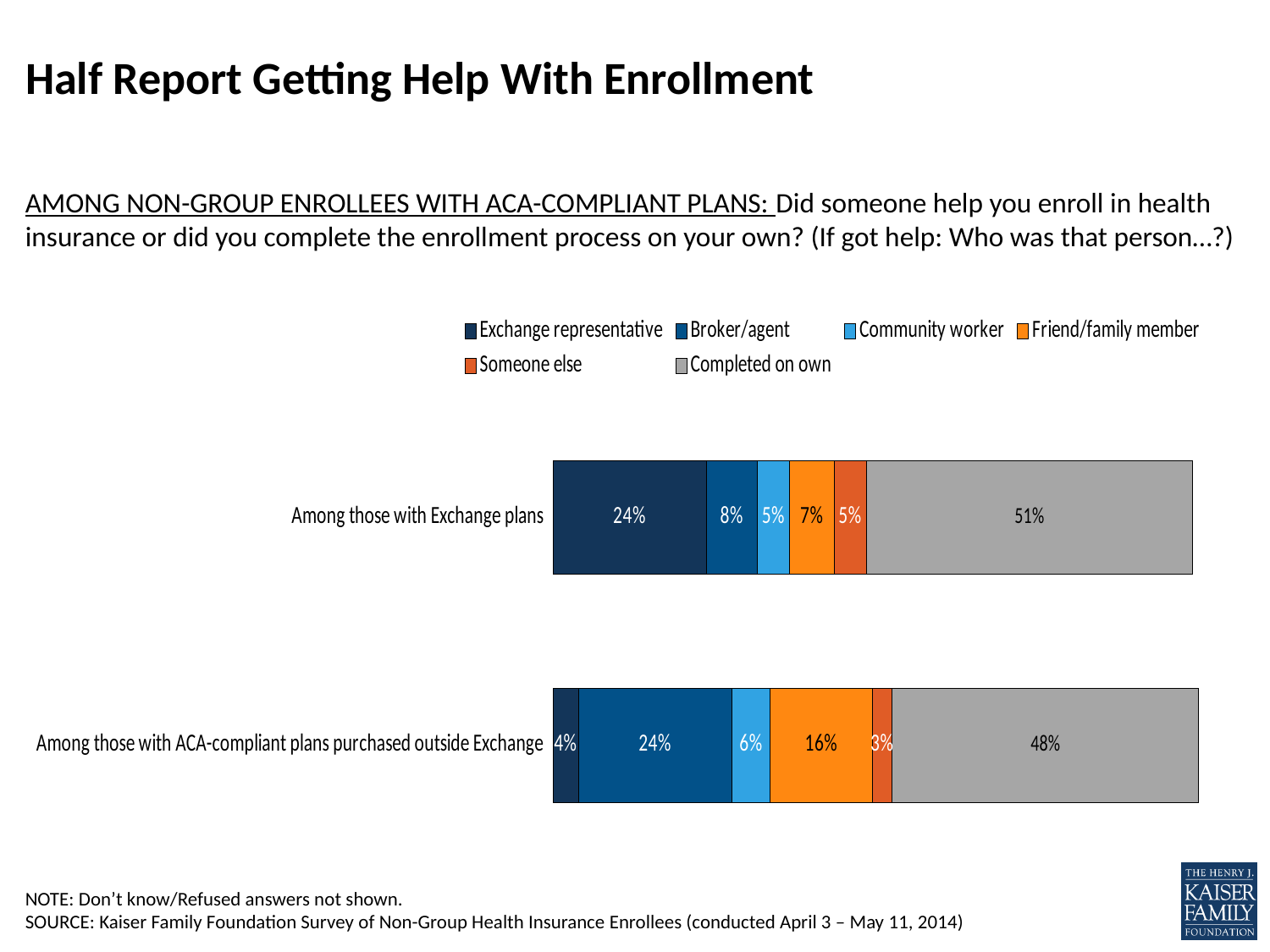
What percentage of those with Exchange plans got help from an Exchange representative? 24% What is the difference between the broker/agent share for those with plans purchased outside the Exchange and those with Exchange plans? 16 percentage points What percentage of those with Exchange plans completed enrollment on their own? 51% What is the difference between the friend/family member share for those with plans purchased outside the Exchange and those with Exchange plans? 9 percentage points Which source of help has the smallest share among those with ACA-compliant plans purchased outside the Exchange? Someone else What kind of chart is shown on the slide? Stacked bar chart What percentage of those with ACA-compliant plans purchased outside the Exchange got help from a broker/agent? 24% Which category has the larger share of enrollees who completed enrollment on their own? Among those with Exchange plans How many series does the legend list? 6 How many categories (bars) are shown in the chart? 2 Which segment is the largest in the bar for those with Exchange plans? Completed on own What percentage of those with ACA-compliant plans purchased outside the Exchange got help from a friend/family member? 16%